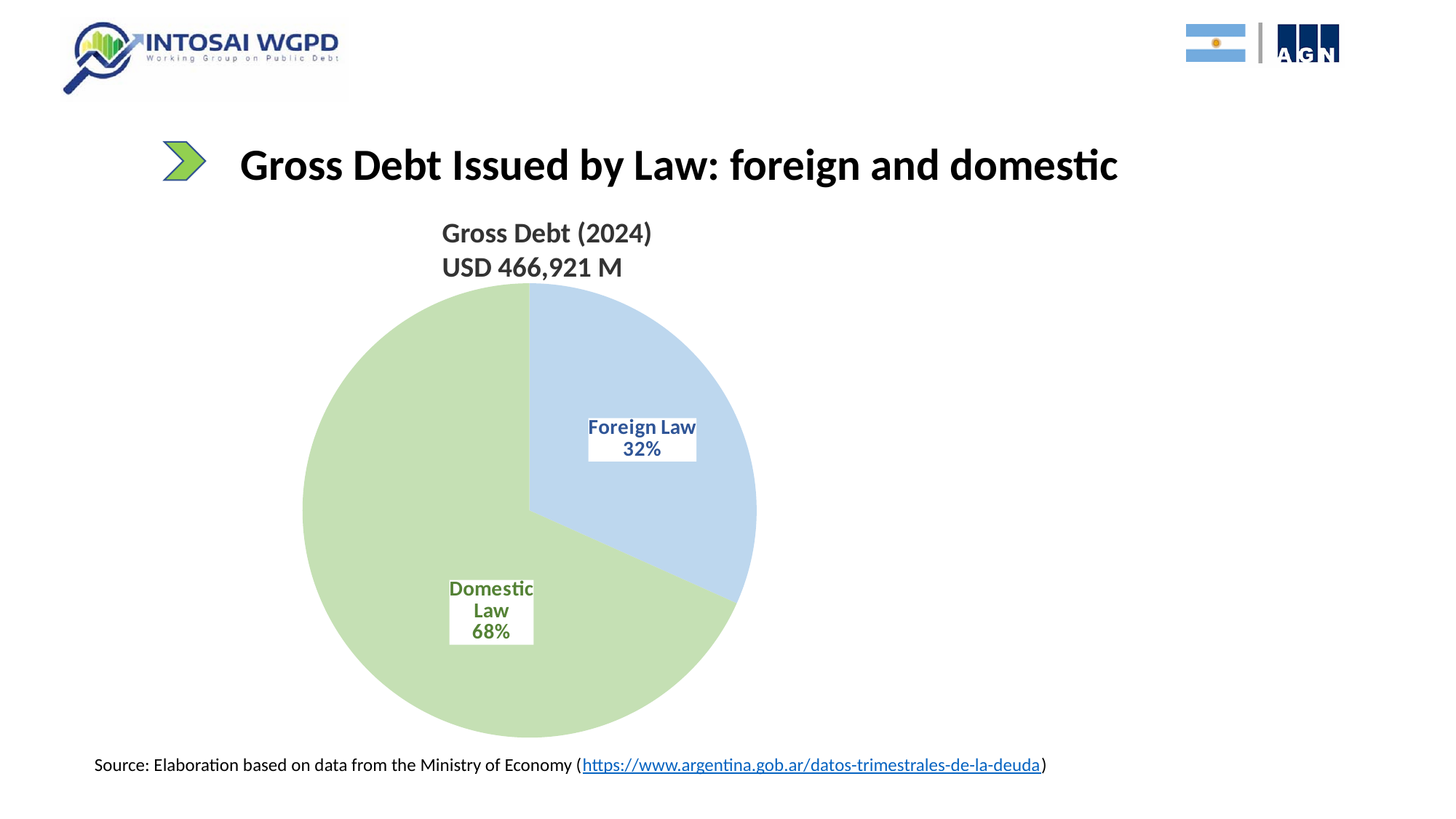
Which slice of the pie is the largest? Domestic Law What share of gross debt is issued under Foreign Law? 32% What type of chart is shown on the slide? Pie chart What is the difference in percentage points between the Domestic Law share and the Foreign Law share? 36 percentage points Which is larger, the Foreign Law share or the Domestic Law share? Domestic Law What share of gross debt is issued under Domestic Law? 68% What colour is the Domestic Law slice? Green How many slices does the pie chart have? 2 Which slice of the pie is the smallest? Foreign Law What total gross debt amount is shown in the chart title? USD 466,921 M What is the title of the pie chart? Gross Debt (2024) USD 466,921 M